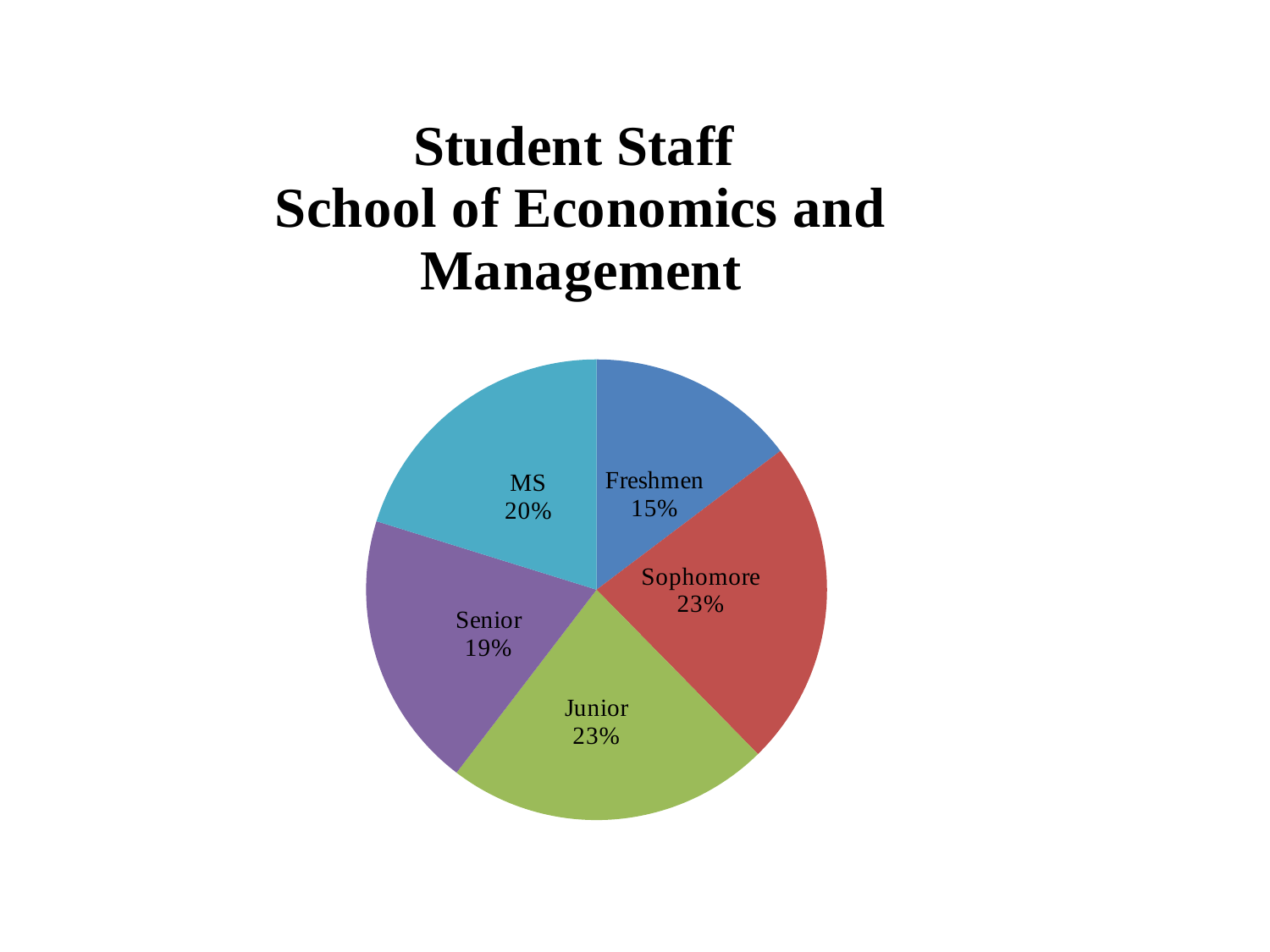
Which category has the smallest slice of the pie? Freshmen What percentage is shown for the Senior slice? 19% How many slices does the pie chart have? 5 Which is larger, the MS slice or the Senior slice? MS What percentage is shown for the MS slice? 20% What percentage is shown for the Junior slice? 23% What is the difference in percentage points between the Sophomore and Freshmen slices? 8 percentage points What share of the pie does the Freshmen slice represent? 15% What is the title of the chart? Student Staff School of Economics and Management What kind of chart is shown on the slide? Pie chart Which is larger, the Sophomore slice or the Freshmen slice? Sophomore What percentage is shown for the Sophomore slice? 23%